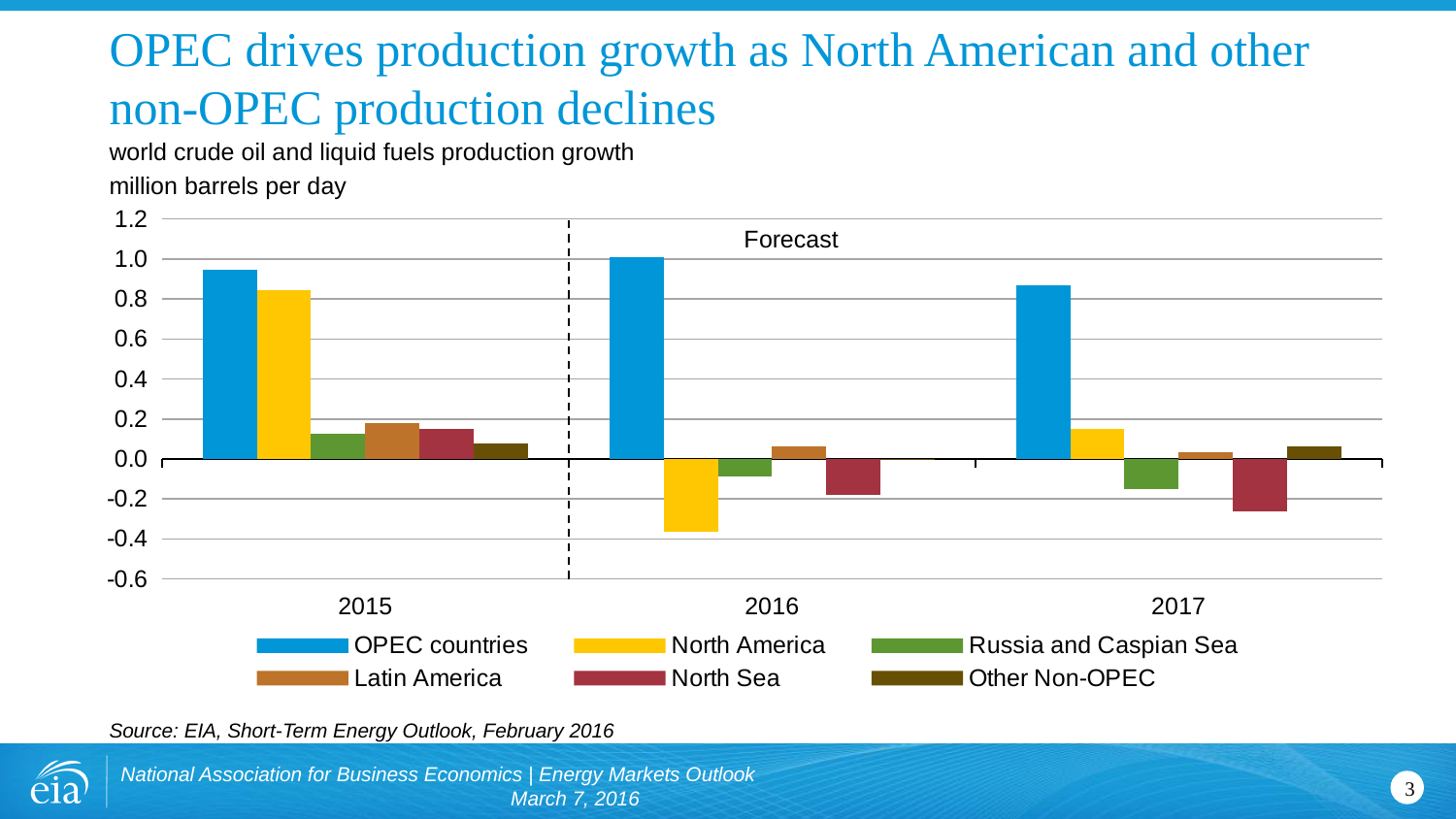
What unit is the chart measured in? million barrels per day Is the value for North America in 2015 greater or less than 0.6? greater Is the value for OPEC countries in 2016 greater or less than 0.8? greater How many years are shown on the x axis? 3 Which series has the highest value in 2016? OPEC countries In 2015, which is larger: OPEC countries or North America? OPEC countries What kind of chart is shown on the slide? bar chart Is the value for North America in 2016 greater or less than -0.2? less Which series has the lowest value in 2017? North Sea How many series does the legend list? 6 Does the value for North Sea rise or fall from 2015 to 2017? fall Which series has the lowest value in 2016? North America